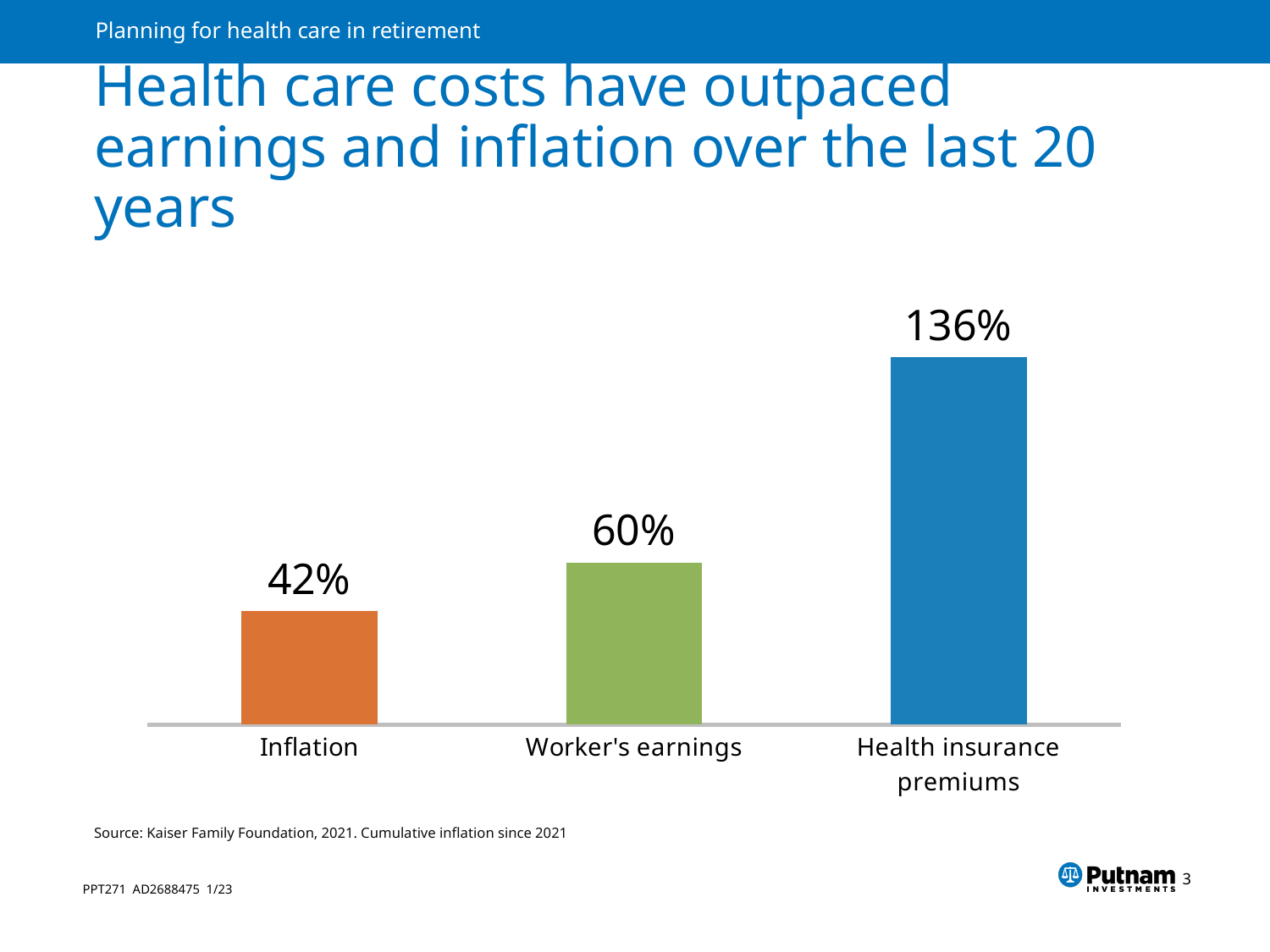
What is the value for Inflation? 42% What kind of chart is shown on the slide? Bar chart Which category has the lowest value? Inflation What is the value for Worker's earnings? 60% Do the values rise or fall from left to right across the categories? Rise What colour is the bar for Health insurance premiums? Blue What is the value for Health insurance premiums? 136% What is the difference between the values for Worker's earnings and Inflation? 18% Which is larger, the value for Worker's earnings or the value for Inflation? Worker's earnings How many categories are shown in the chart? 3 What is the difference between the values for Health insurance premiums and Inflation? 94% Which category has the highest value? Health insurance premiums